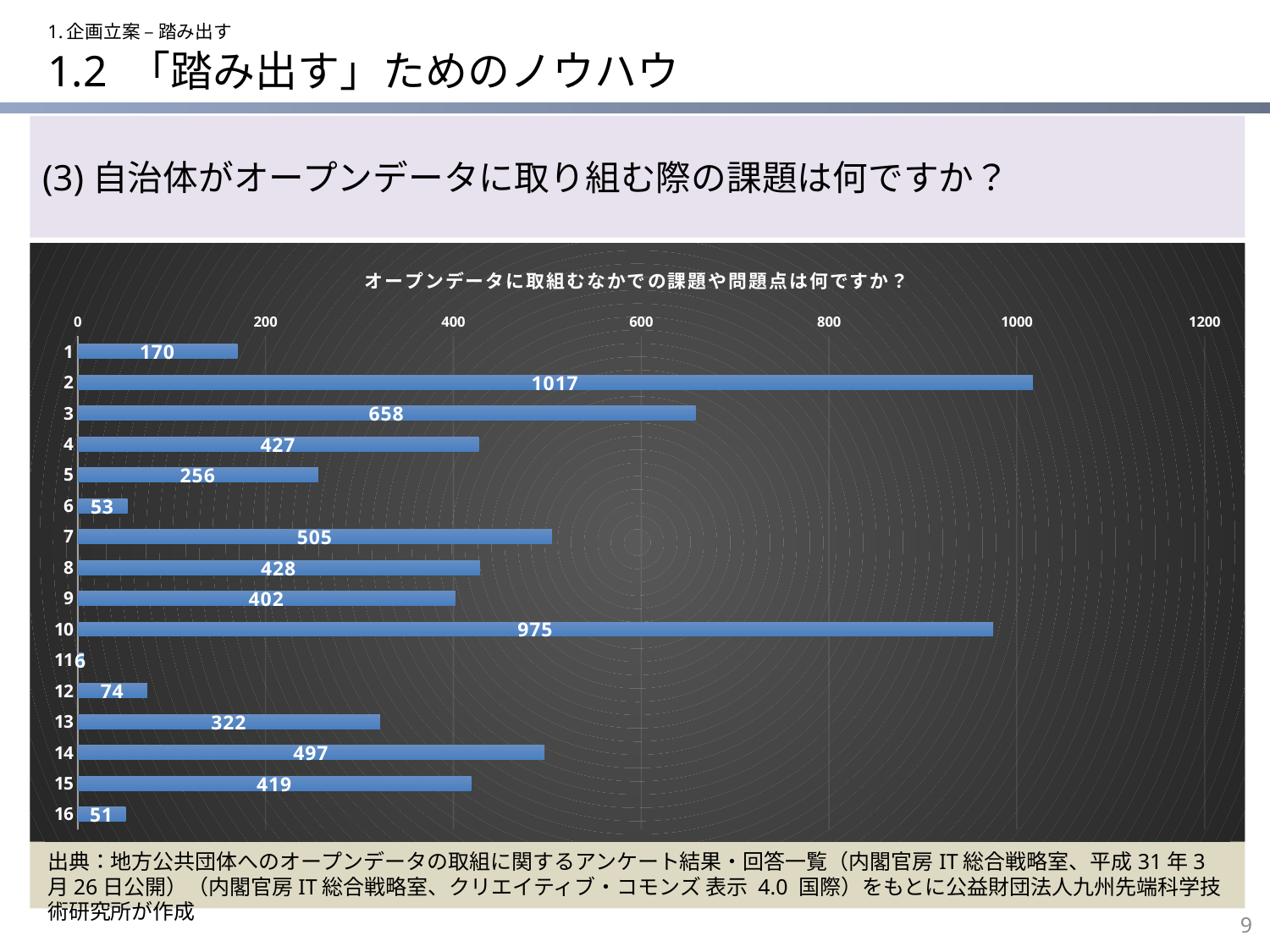
What is the value for category 2? 1017 What is the value for category 16? 51 What is the value for category 10? 975 How many categories are shown in the chart? 16 What is the difference between the values for category 2 and category 10? 42 What kind of chart is shown on the slide? bar chart Is the value for category 5 greater or less than 400? less What is the value for category 13? 322 Which category has the highest value? 2 Which category has the lowest value? 11 Which has a larger value, category 3 or category 10? 10 What is the difference between the values for category 3 and category 4? 231